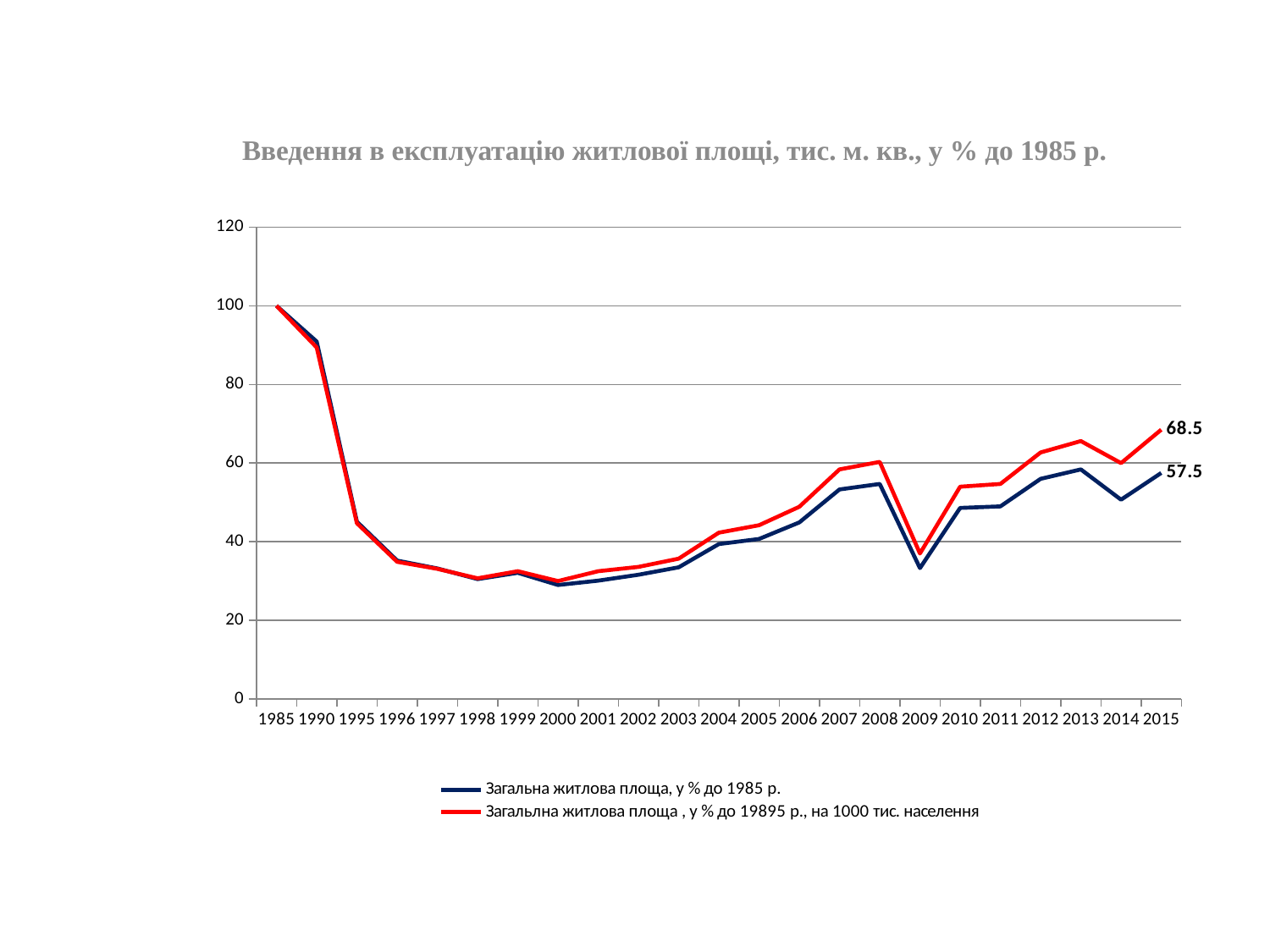
Which series has the larger value in 2015, the red one or the navy one? the red series (Загальна житлова площа, у % до 19895 р., на 1000 тис. населення) In which year do both series reach their highest value? 1985 What is the difference between the red and navy series values in 2015? 11 Is the value of the red series in 2008 greater or less than 40? greater Do the values fall or rise between 1985 and 1995? fall How many series does the legend list? 2 Is the value of the navy series in 2009 greater or less than 40? less How many years are shown on the x axis? 23 What is the value of the navy series (Загальна житлова площа, у % до 1985 р.) in 2015? 57.5 What is the title of the chart? Введення в експлуатацію житлової площі, тис. м. кв., у % до 1985 р. What is the value of the red series (Загальна житлова площа, у % до 19895 р., на 1000 тис. населення) in 2015? 68.5 What kind of chart is shown on the slide? line chart